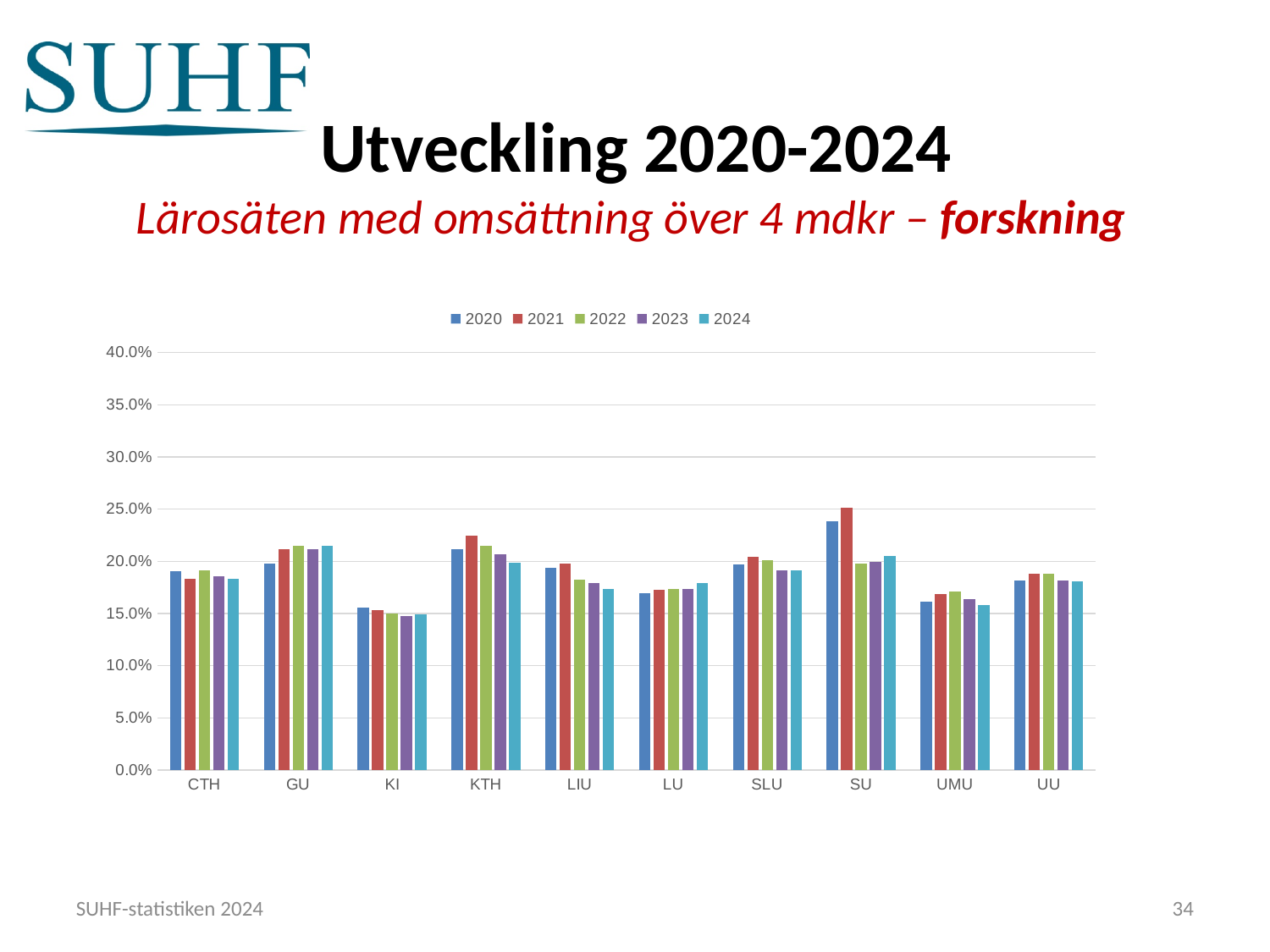
Which colour represents the 2021 series in the legend? red Which is larger for SU: the 2020 value or the 2024 value? 2020 How many series does the legend list? 5 Is the value for KTH in 2021 greater or less than 20.0%? greater Do the values for LIU rise or fall from 2020 to 2024? fall How many universities (categories) are shown on the x axis? 10 Is the value for KI in 2023 greater or less than 20.0%? less Which is larger in 2021: KTH or LU? KTH Which university has the lowest value for 2020? KI What kind of chart is shown on the slide? bar chart Which university has the highest value for 2021? SU Is the value for SU in 2021 greater or less than 20.0%? greater